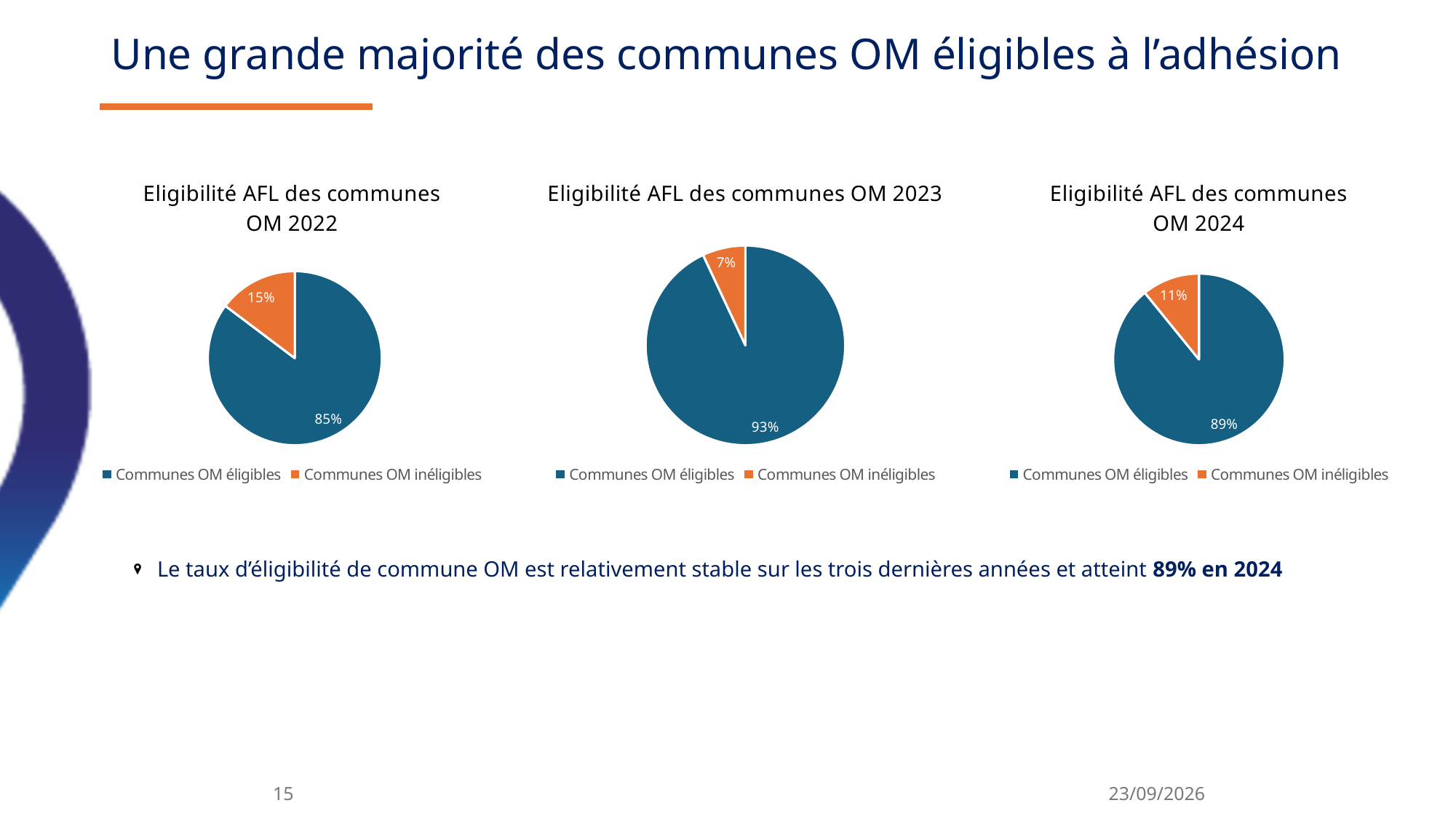
Is the 'Communes OM inéligibles' share larger in the 2022 chart or in the 2023 chart? 2022 In the chart titled 'Eligibilité AFL des communes OM 2022', what share of the pie is 'Communes OM éligibles'? 85% In the chart titled 'Eligibilité AFL des communes OM 2023', what share of the pie is 'Communes OM inéligibles'? 7% How many categories does the legend of the chart titled 'Eligibilité AFL des communes OM 2022' list? 2 In the chart titled 'Eligibilité AFL des communes OM 2024', which category is the smallest? Communes OM inéligibles What kind of chart is 'Eligibilité AFL des communes OM 2024'? Pie chart In the chart titled 'Eligibilité AFL des communes OM 2023', what is the value for 'Communes OM éligibles'? 93% In the chart titled 'Eligibilité AFL des communes OM 2023', what is the difference between 'Communes OM éligibles' and 'Communes OM inéligibles'? 86% In the chart titled 'Eligibilité AFL des communes OM 2022', what is the value for 'Communes OM inéligibles'? 15% In the chart titled 'Eligibilité AFL des communes OM 2024', what is the value for 'Communes OM éligibles'? 89% In the chart titled 'Eligibilité AFL des communes OM 2022', which category is the largest? Communes OM éligibles In the chart titled 'Eligibilité AFL des communes OM 2024', what is the value for 'Communes OM inéligibles'? 11%